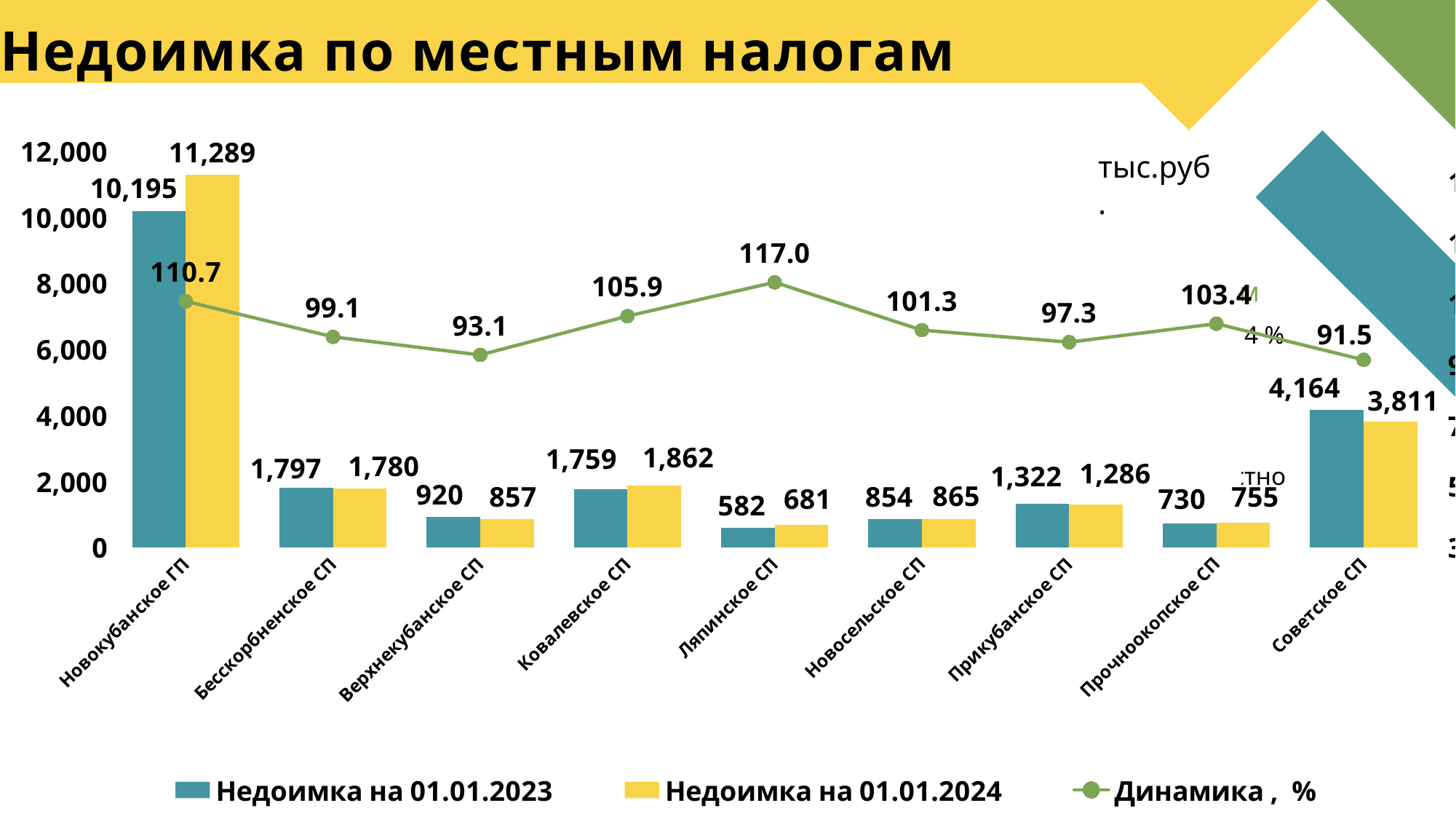
Which is larger for Ковалевское СП: Недоимка на 01.01.2023 or Недоимка на 01.01.2024? Недоимка на 01.01.2024 How many series does the legend list? 3 Which category has the lowest Недоимка на 01.01.2023? Ляпинское СП What is the value of Недоимка на 01.01.2024 for Советское СП? 3,811 Which category has the highest Недоимка на 01.01.2024? Новокубанское ГП What is the title of the slide? Недоимка по местным налогам Which category has the lowest Динамика, % value? Советское СП What is the difference between Недоимка на 01.01.2024 and Недоимка на 01.01.2023 for Новокубанское ГП? 1,094 What is the value of Недоимка на 01.01.2023 for Новокубанское ГП? 10,195 Is the Недоимка на 01.01.2023 value for Советское СП greater or less than 4,000? greater How many categories are shown on the x axis? 9 What is the Динамика, % value for Ляпинское СП? 117.0